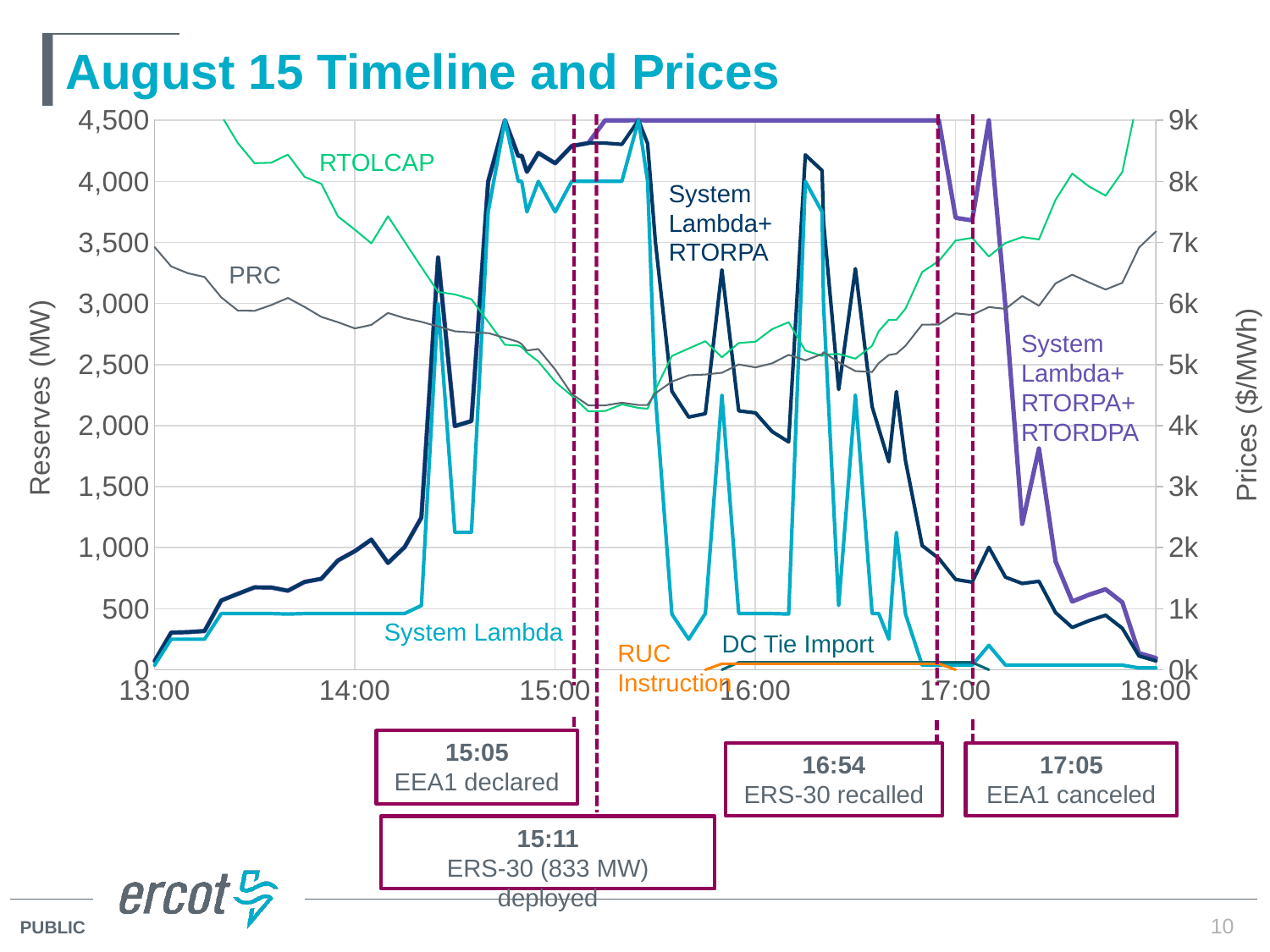
At what time was EEA1 canceled? 17:05 What is the title of the chart on the slide? August 15 Timeline and Prices Does the PRC series rise or fall between 13:00 and 15:00? fall What kind of chart is shown on the slide? line chart Does the RTOLCAP series rise or fall between 17:00 and 18:00? rise How many MW of ERS-30 were deployed at 15:11? 833 MW At what time was ERS-30 recalled? 16:54 Is the PRC value at 13:00 greater or less than 3,000 MW? greater How many labeled series are plotted on the chart? 7 What is the label of the right-hand vertical axis? Prices ($/MWh) Is the RTOLCAP value at 15:00 greater or less than 2,500 MW? less At what time was EEA1 declared, according to the chart annotation? 15:05